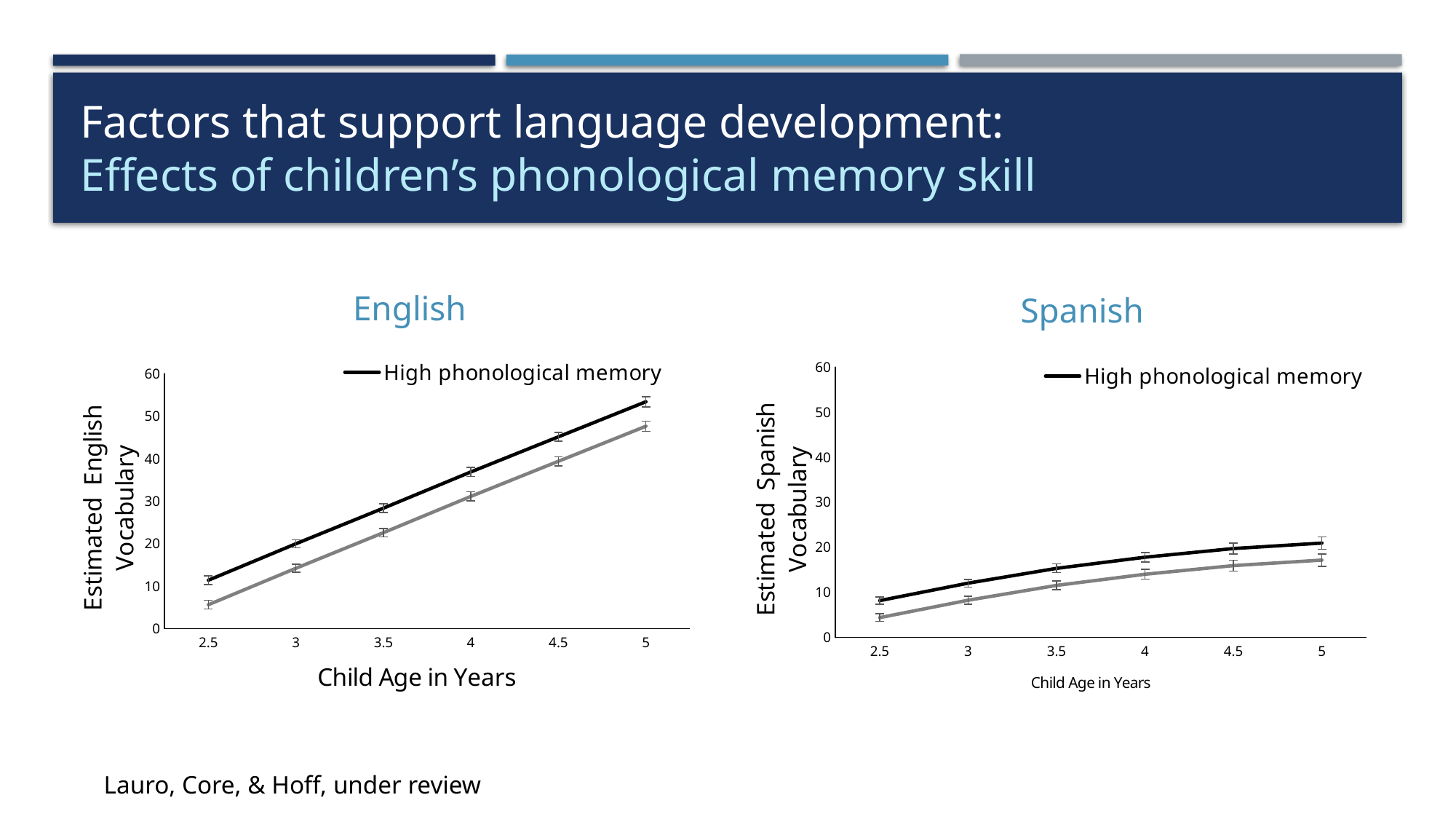
What kind of chart is the English chart? line chart In the English chart, is the High phonological memory value at age 5 greater or less than 50? greater In the Spanish chart, is the High phonological memory value at age 2.5 greater or less than 10? less In the Spanish chart, is the High phonological memory value at age 5 greater or less than 30? less In the English chart, how many child age points are shown on the x axis? 6 In the English chart, at age 5, which line is higher: the black High phonological memory line or the gray line? the black High phonological memory line What is the x-axis label of the English chart? Child Age in Years In the English chart, does the High phonological memory line rise or fall as child age increases? rise How many series does the legend of the Spanish chart list? 1 What kind of chart is the Spanish chart? line chart In the Spanish chart, does the High phonological memory line rise or fall as child age increases? rise